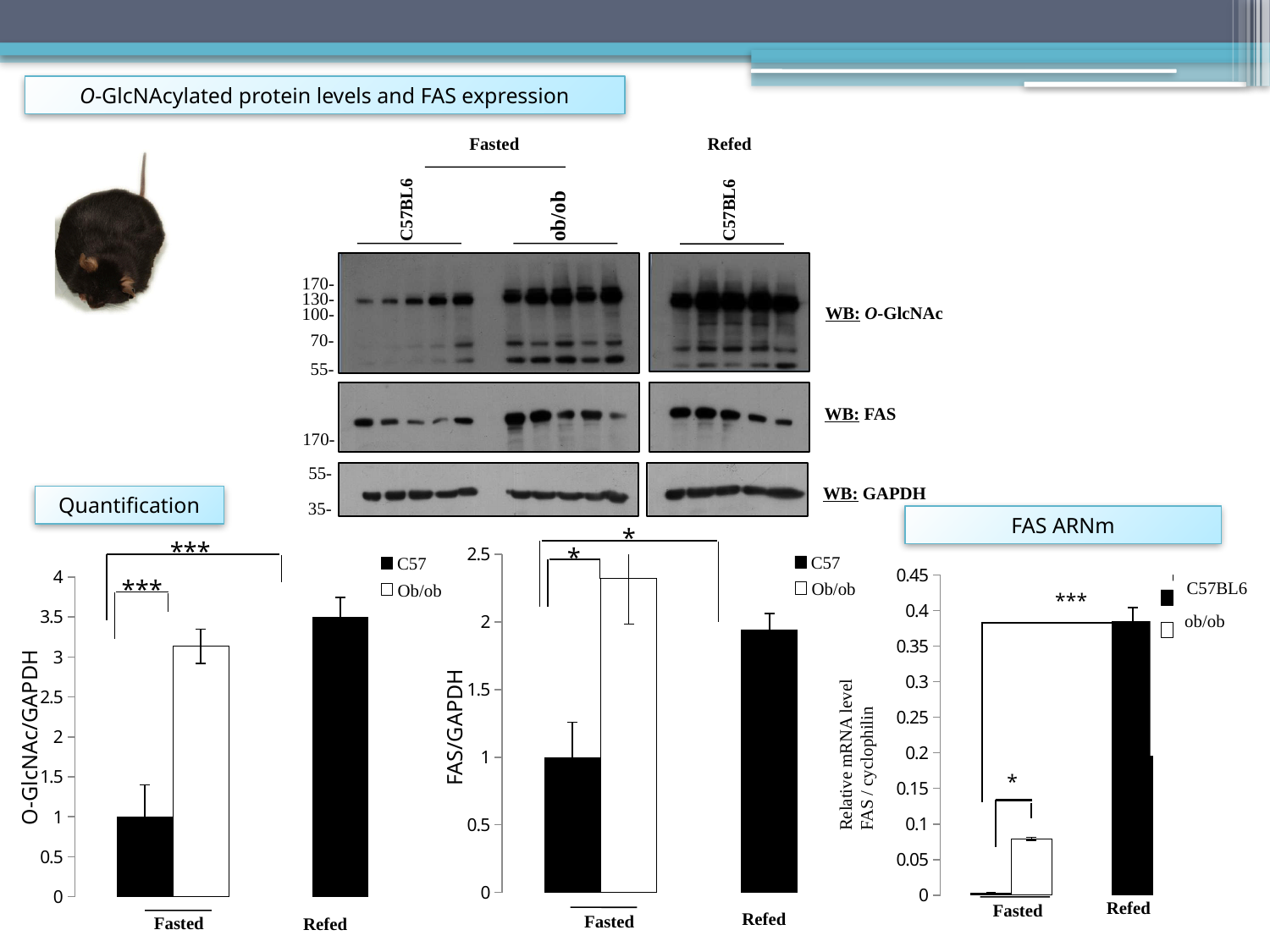
What is the y-axis label of the middle chart? FAS/GAPDH What are the legend entries of the FAS ARNm chart on the right? C57BL6 and ob/ob In the left chart (O-GlcNAc/GAPDH), is the value for C57 in the Fasted condition greater or less than 1.5? less In the middle chart (FAS/GAPDH), is the value for Ob/ob in the Fasted condition greater or less than 2? greater In the FAS ARNm chart, is the value for C57BL6 in the Refed condition greater or less than 0.3? greater In the left chart (O-GlcNAc/GAPDH), how many series does the legend list? 2 In the left chart (O-GlcNAc/GAPDH), which Fasted bar is larger, C57 or Ob/ob? Ob/ob In the FAS ARNm chart, which bar is the highest? C57BL6 Refed What kind of chart is the left chart with the y-axis O-GlcNAc/GAPDH? bar chart